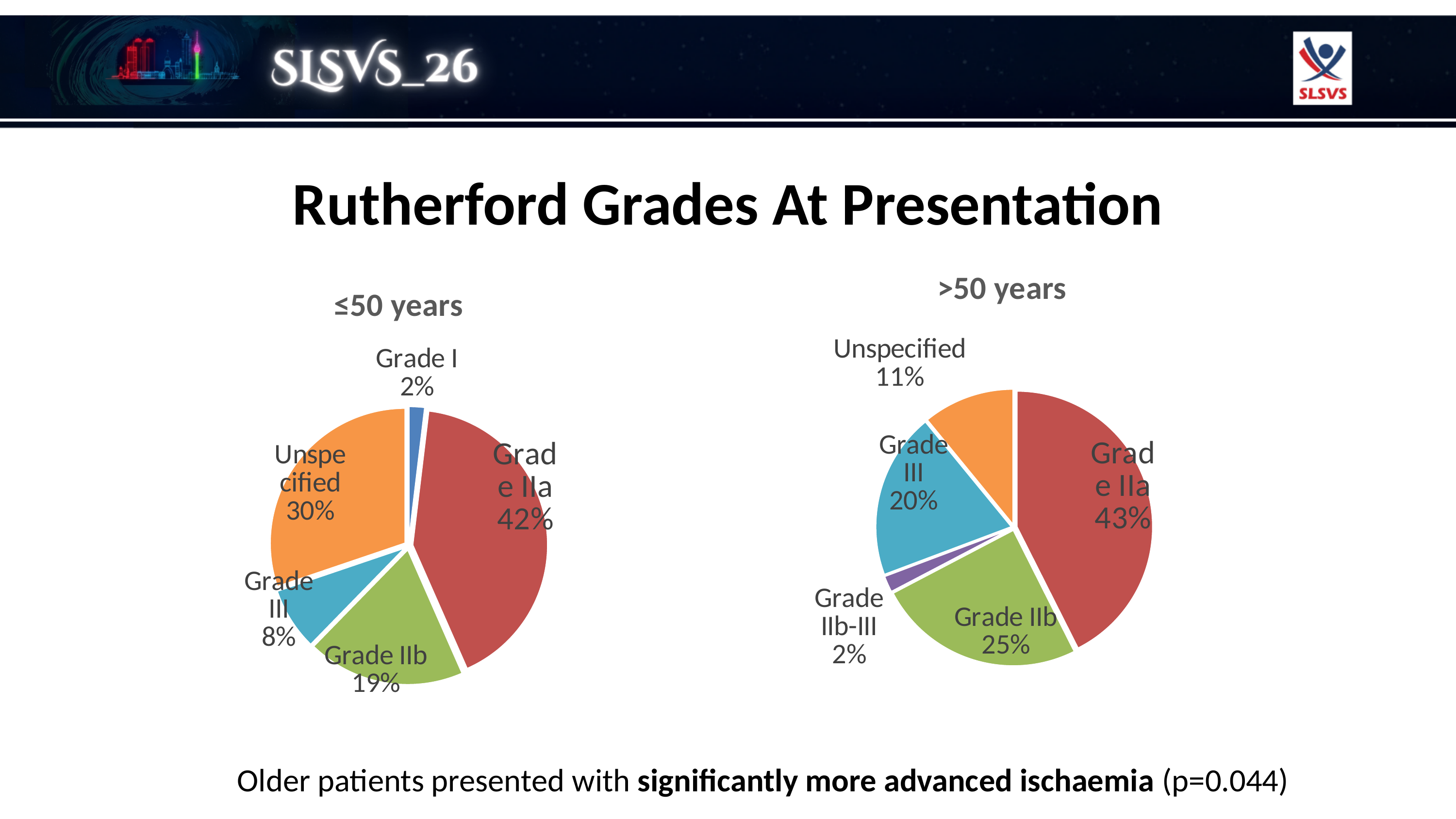
In the >50 years pie chart, what share is Grade III? 20% What is the title of the chart on the right? >50 years In the ≤50 years pie chart, what share is Unspecified? 30% In the ≤50 years pie chart, which category has the largest share? Grade IIa How many slices does the >50 years pie chart have? 5 In the ≤50 years pie chart, what share is Grade IIa? 42% In the ≤50 years pie chart, which category has the smallest share? Grade I In the ≤50 years pie chart, which is larger: Grade IIb or Grade III? Grade IIb In the >50 years pie chart, which category has the smallest share? Grade IIb-III What type of chart is used for the ≤50 years data? Pie chart In the >50 years pie chart, what share is Grade IIb? 25% In the >50 years pie chart, what is the difference between the Grade IIa share and the Grade IIb share? 18%